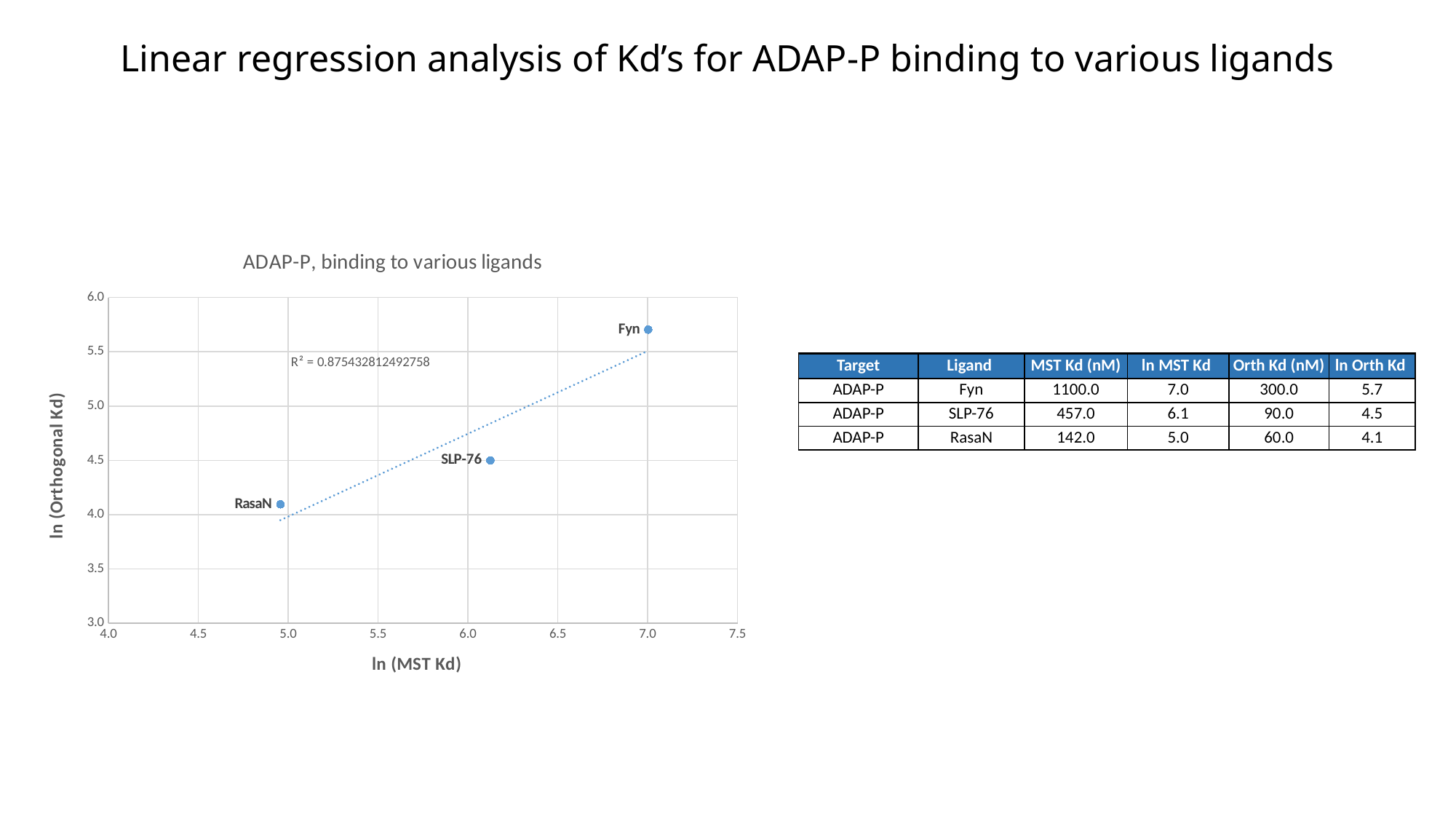
Which ligand has the highest ln (Orthogonal Kd) value in the chart? Fyn What R² value is printed on the chart? 0.875432812492758 What kind of chart is shown on the slide? scatter chart Is the ln (Orthogonal Kd) value for Fyn greater or less than 5.5? greater According to the table, what is the ln Orth Kd value for SLP-76? 4.5 Which ligand has the lowest ln (MST Kd) value in the chart? RasaN Is the ln (Orthogonal Kd) value for RasaN greater or less than 4.5? less According to the table, what is the ln MST Kd value for Fyn? 7.0 Which has a larger ln (Orthogonal Kd) value, SLP-76 or RasaN? SLP-76 What is the title of the chart? ADAP-P, binding to various ligands How many data points are plotted in the chart? 3 Do the ln (Orthogonal Kd) values rise or fall as ln (MST Kd) increases along the x axis? rise